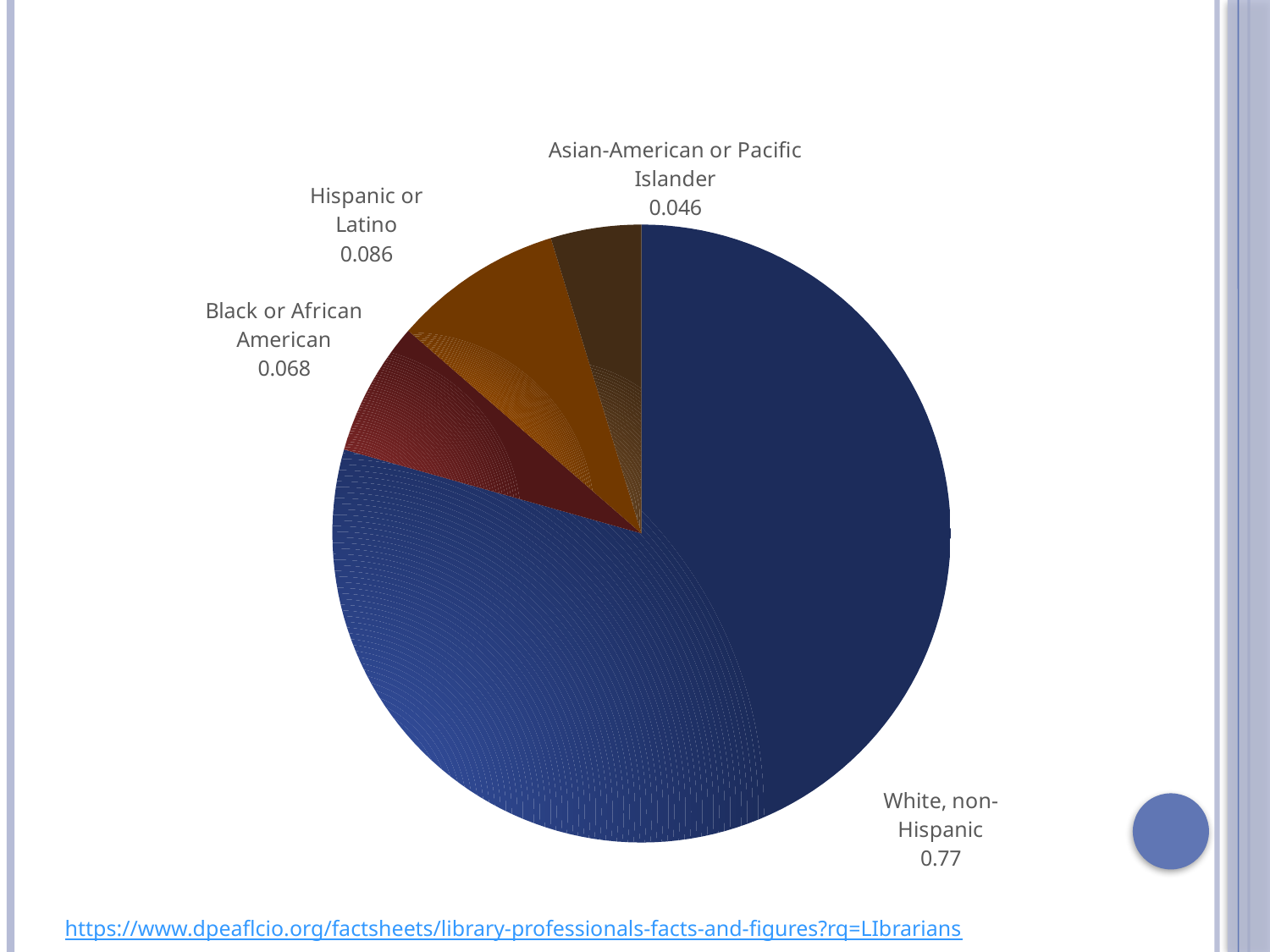
Which category has the smallest slice of the pie? Asian-American or Pacific Islander What kind of chart is shown on the slide? pie chart What is the value shown for Asian-American or Pacific Islander? 0.046 What is the value shown for White, non-Hispanic? 0.77 How many categories are shown in the pie chart? 4 What colour is the slice for White, non-Hispanic? blue Which is larger, the value for Hispanic or Latino or the value for Black or African American? Hispanic or Latino Which category has the largest slice of the pie? White, non-Hispanic What is the difference between the value for White, non-Hispanic and the value for Hispanic or Latino? 0.684 What is the value shown for Black or African American? 0.068 What is the difference between the value for Hispanic or Latino and the value for Black or African American? 0.018 What is the value shown for Hispanic or Latino? 0.086